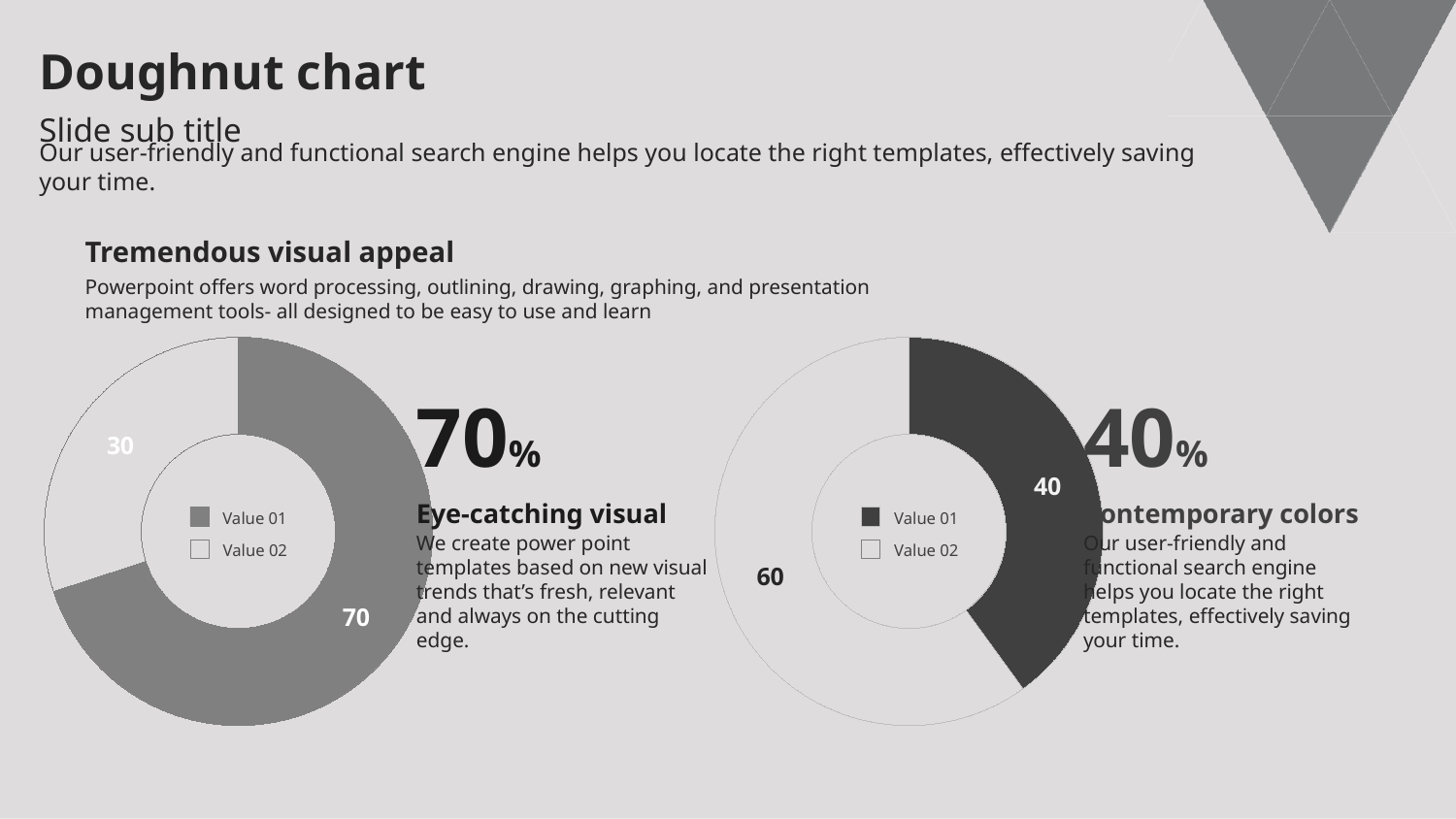
In the left doughnut chart, what share of the total does Value 01 represent? 70% In the left doughnut chart, what is the value for Value 01? 70 In the right doughnut chart, which is larger, Value 01 or Value 02? Value 02 In the right doughnut chart, what is the value for Value 01? 40 What type of chart is shown on the left of the slide? Doughnut chart In the left doughnut chart, what is the difference between Value 01 and Value 02? 40 In the right doughnut chart, what is the value for Value 02? 60 In the right doughnut chart, what is the difference between Value 02 and Value 01? 20 In the right doughnut chart, which category has the smallest value? Value 01 In the left doughnut chart, which category has the largest value? Value 01 How many categories does the legend of the left doughnut chart list? 2 In the left doughnut chart, what is the value for Value 02? 30